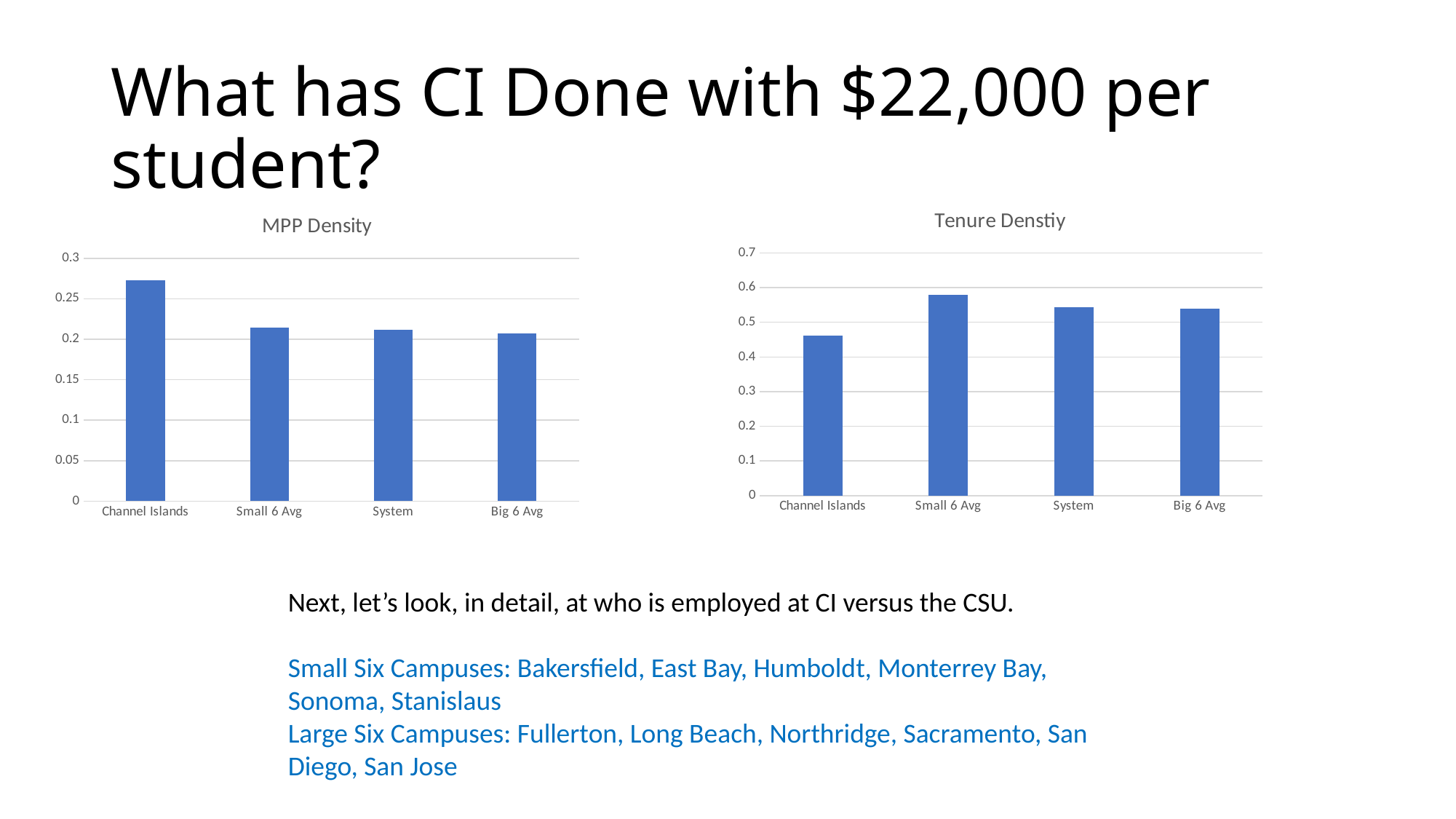
On the MPP Density chart, which category has the highest value? Channel Islands What is the title of the chart on the right side of the slide? Tenure Denstiy On the Tenure Denstiy chart, which is larger, the value for Channel Islands or the value for Big 6 Avg? Big 6 Avg On the Tenure Denstiy chart, is the value for Channel Islands greater or less than 0.5? less On the Tenure Denstiy chart, is the value for Small 6 Avg greater or less than 0.5? greater How many categories are shown on the Tenure Denstiy chart? 4 What kind of chart is the MPP Density chart? bar chart On the MPP Density chart, which is larger, the value for Channel Islands or the value for System? Channel Islands On the Tenure Denstiy chart, which category has the lowest value? Channel Islands On the Tenure Denstiy chart, which category has the highest value? Small 6 Avg On the MPP Density chart, is the value for Big 6 Avg greater or less than 0.25? less